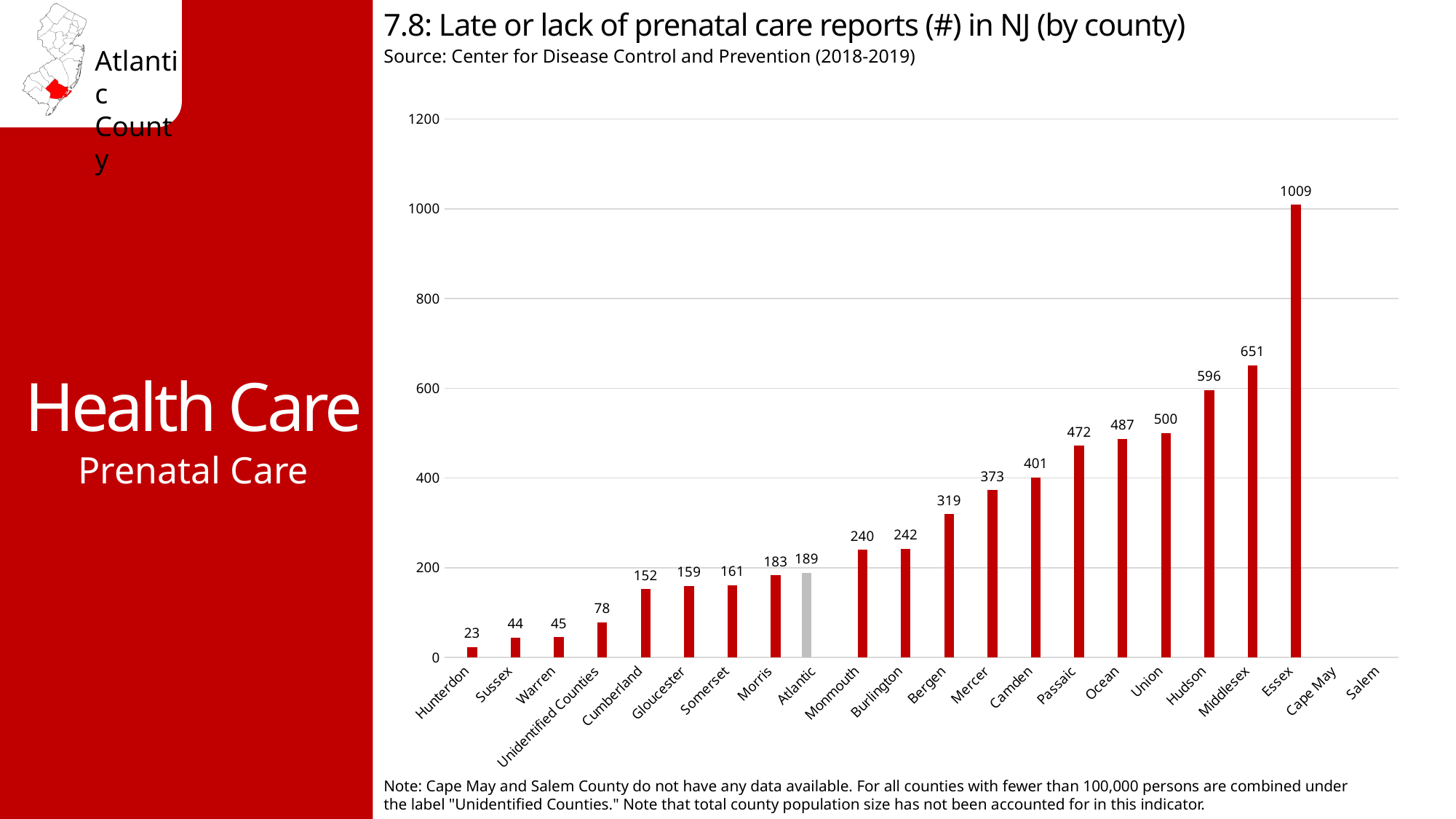
What kind of chart is shown on the slide? Bar chart Which bar is coloured grey instead of red? Atlantic Which has a higher value, Hudson or Union? Hudson Which county with a plotted bar has the lowest number of reports? Hunterdon What is the difference between the values for Essex and Middlesex? 358 What is the value shown for Essex? 1009 What is the number of late or lack of prenatal care reports for Atlantic County? 189 Is the value for Camden greater or less than 400? greater Which county has the highest number of late or lack of prenatal care reports? Essex How many county categories are listed on the x axis? 22 Do the values generally rise or fall from left to right along the x axis? Rise What is the value shown for Unidentified Counties? 78